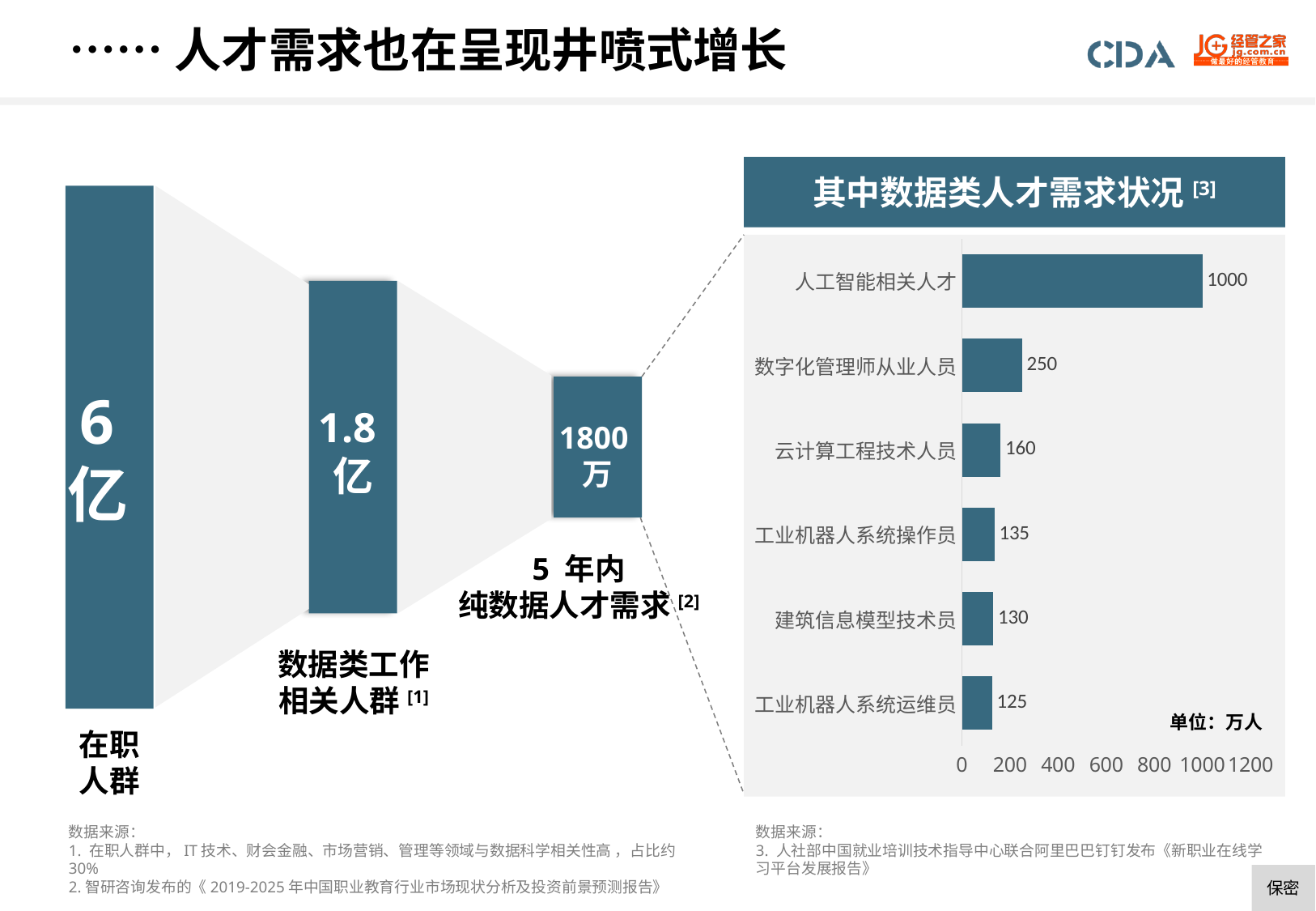
In the chart titled 其中数据类人才需求状况, which category has the lowest value? 工业机器人系统运维员 In the chart titled 其中数据类人才需求状况, what is the value for 工业机器人系统运维员? 125 In the chart titled 其中数据类人才需求状况, what is the value for 数字化管理师从业人员? 250 In the chart titled 其中数据类人才需求状况, what is the difference between the values for 工业机器人系统操作员 and 建筑信息模型技术员? 5 How many categories are shown in the chart titled 其中数据类人才需求状况? 6 What kind of chart is the one titled 其中数据类人才需求状况? bar chart In the chart titled 其中数据类人才需求状况, what is the difference between the values for 人工智能相关人才 and 数字化管理师从业人员? 750 In the chart titled 其中数据类人才需求状况, which is larger: the value for 云计算工程技术人员 or the value for 数字化管理师从业人员? 数字化管理师从业人员 In the chart titled 其中数据类人才需求状况, what is the value for 云计算工程技术人员? 160 What unit is stated for the values in the chart titled 其中数据类人才需求状况? 万人 In the chart titled 其中数据类人才需求状况, which category has the highest value? 人工智能相关人才 In the chart titled 其中数据类人才需求状况, what is the value for 人工智能相关人才? 1000